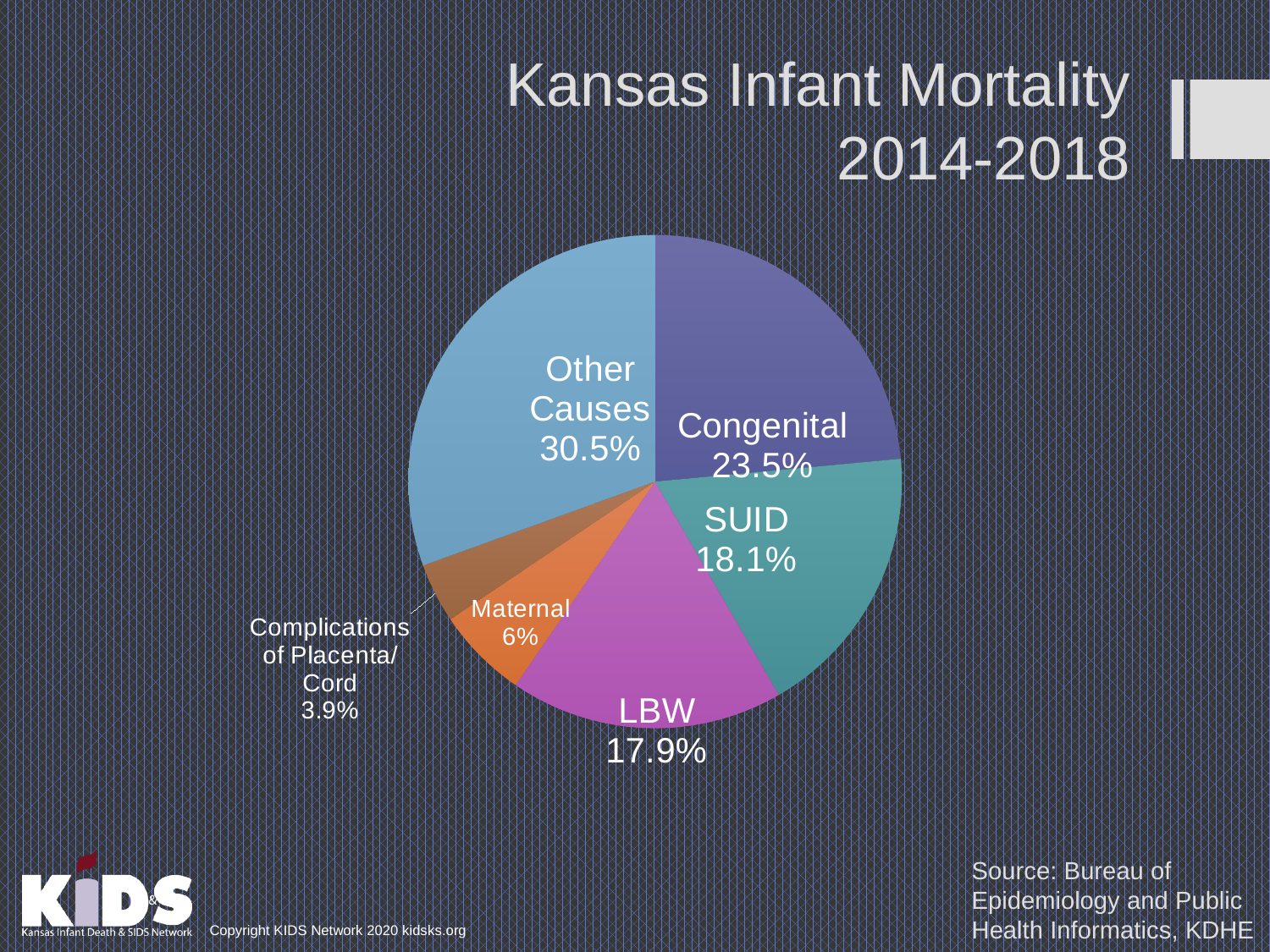
What kind of chart is shown on the slide? pie chart What is the combined share of Congenital and SUID? 41.6% What is the value for Complications of Placenta/Cord? 3.9% What is the value shown for SUID? 18.1% Which category has the smallest share of the pie? Complications of Placenta/Cord What percentage is shown for LBW? 17.9% What is the title of the chart on the slide? Kansas Infant Mortality 2014-2018 How many categories are shown in the pie chart? 6 Which is larger, the share for Maternal or the share for Complications of Placenta/Cord? Maternal Which category has the largest share of the pie? Other Causes What percentage of Kansas infant mortality is attributed to Congenital causes? 23.5% What is the difference between the Other Causes share and the Congenital share? 7%